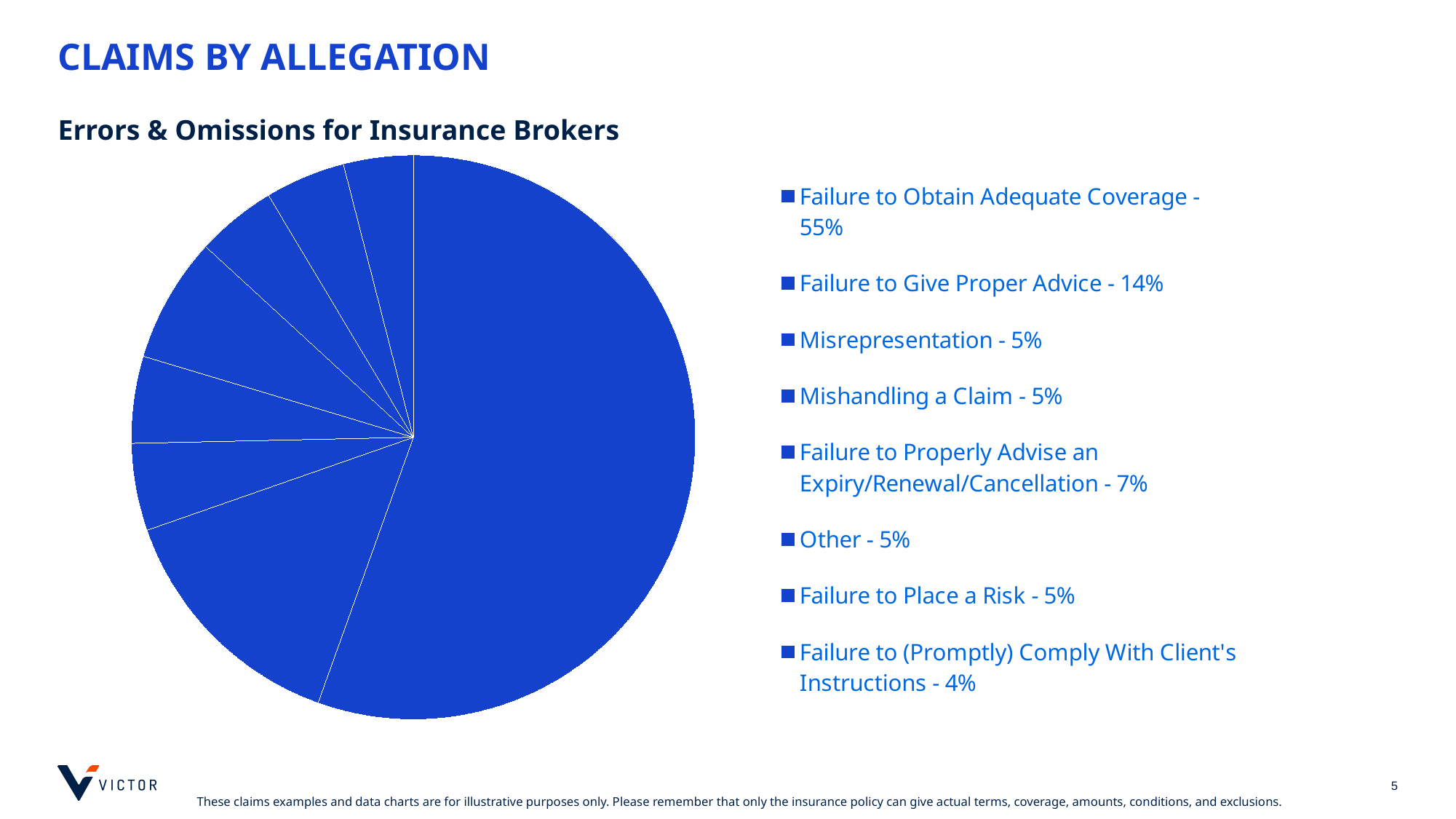
What is the title of the slide containing the pie chart? CLAIMS BY ALLEGATION What percentage of claims is for Failure to Properly Advise an Expiry/Renewal/Cancellation? 7% Which is larger: the share for Failure to Give Proper Advice or the share for Failure to Properly Advise an Expiry/Renewal/Cancellation? Failure to Give Proper Advice What is the difference in percentage points between Failure to Obtain Adequate Coverage and Failure to Give Proper Advice? 41 percentage points What percentage of claims is for Failure to (Promptly) Comply With Client's Instructions? 4% What kind of chart is shown on the slide? Pie chart What is the subtitle shown above the pie chart? Errors & Omissions for Insurance Brokers How many categories (slices) does the pie chart have? 8 Which allegation category accounts for the largest share of claims? Failure to Obtain Adequate Coverage What share of claims is attributed to Failure to Obtain Adequate Coverage? 55% What percentage of claims is for Failure to Give Proper Advice? 14% Which allegation category accounts for the smallest share of claims? Failure to (Promptly) Comply With Client's Instructions